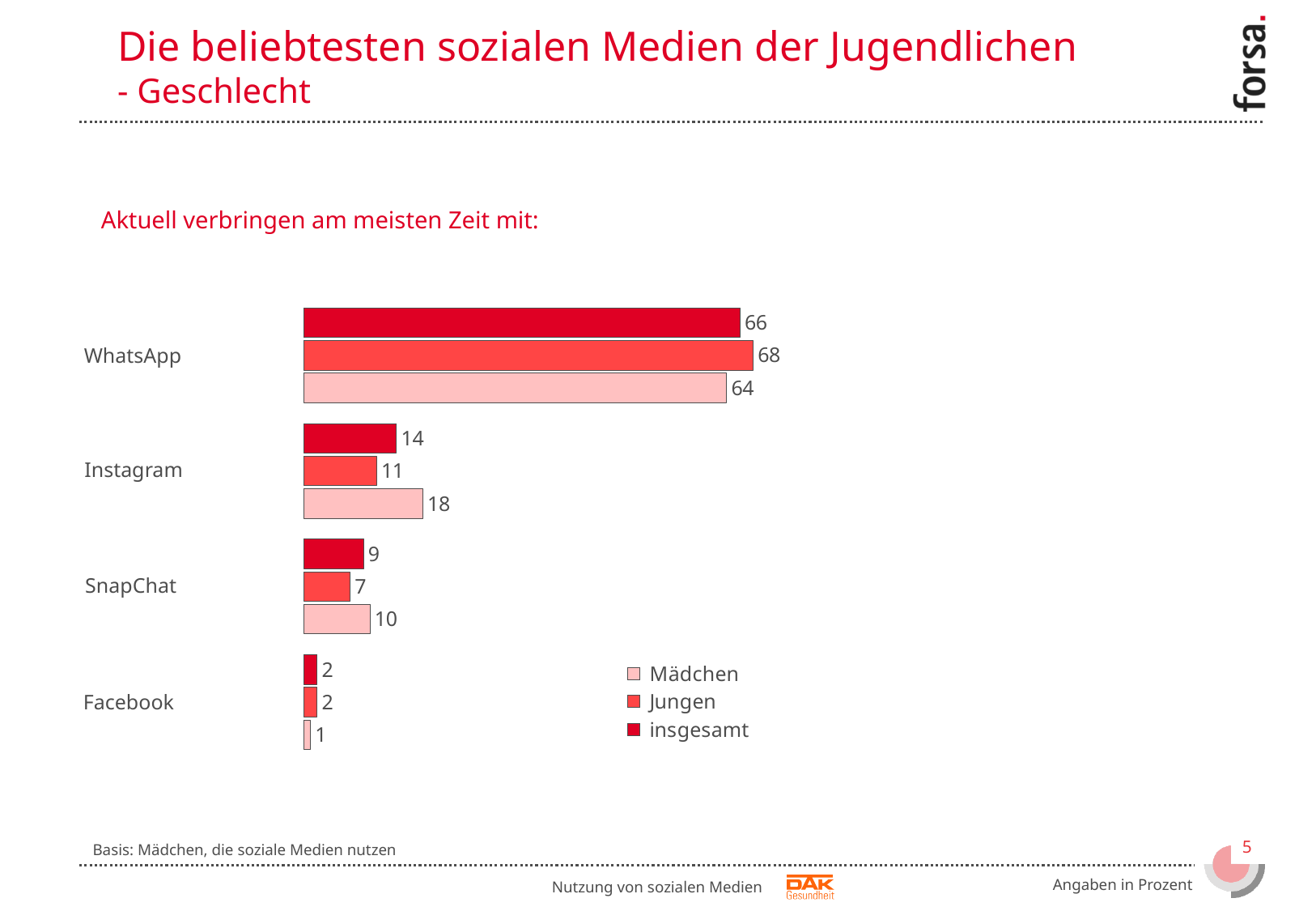
What is the value for Mädchen for Instagram? 18 How many categories are shown on the chart? 4 What is the value for Jungen for WhatsApp? 68 Which series is shown in the lightest pink colour? Mädchen How many series does the legend list? 3 What kind of chart is shown on the slide? bar chart Which category has the highest insgesamt value? WhatsApp What is the value for Mädchen for Facebook? 1 What is the difference between the Mädchen and Jungen values for Instagram? 7 What is the insgesamt value for SnapChat? 9 Which is larger for WhatsApp, the value for Jungen or the value for Mädchen? Jungen Which category has the lowest value for Mädchen? Facebook